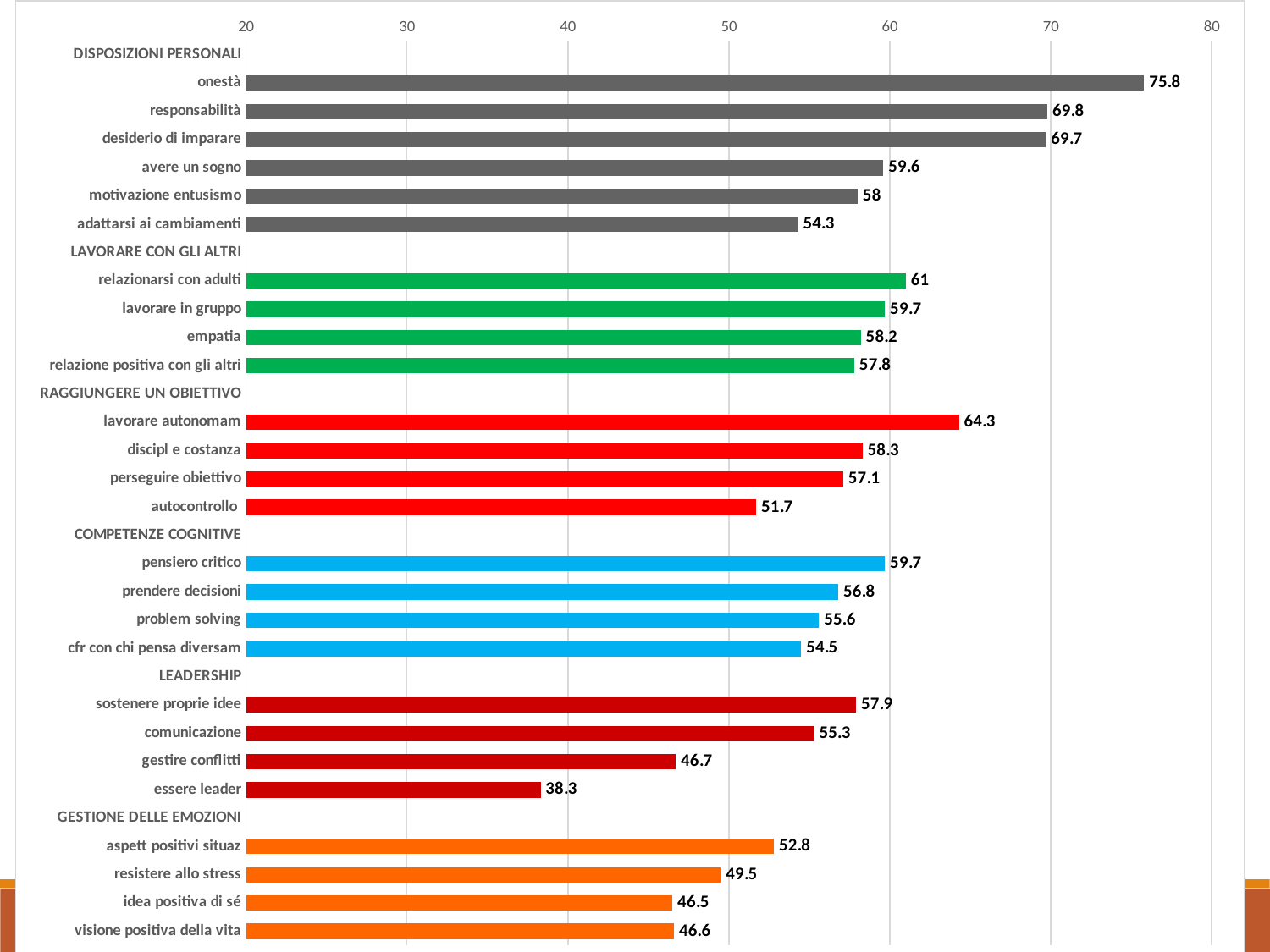
What is the difference between the values for lavorare autonomam and autocontrollo? 12.6 Which category has the highest value? onestà What is the value for lavorare autonomam? 64.3 What is the value for onestà? 75.8 Which category has the lowest value? essere leader What colour are the bars in the LEADERSHIP group? dark red How many bars are plotted in the chart? 26 What is the value for resistere allo stress? 49.5 What kind of chart is shown on the slide? bar chart Is the value for gestire conflitti greater or less than 50? less What is the difference between the values for onestà and essere leader? 37.5 Which is larger, the value for pensiero critico or the value for gestire conflitti? pensiero critico